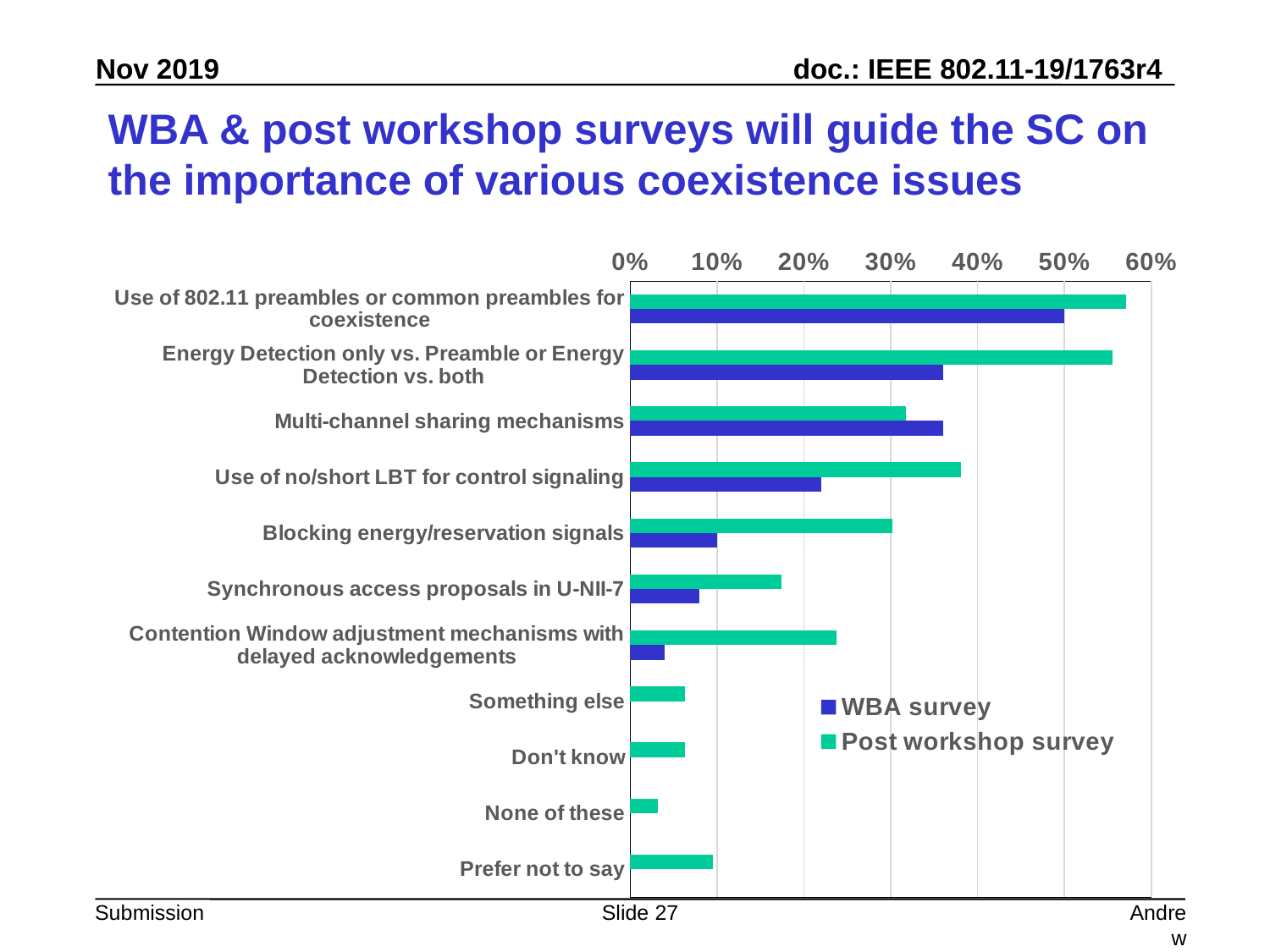
Which series is shown in green in the legend? Post workshop survey For Multi-channel sharing mechanisms, which series has the larger value: WBA survey or Post workshop survey? WBA survey How many series does the legend list? 2 Is the Post workshop survey value for Energy Detection only vs. Preamble or Energy Detection vs. both greater or less than 50%? greater How many categories are shown on the chart? 11 Which category has the highest value for the WBA survey? Use of 802.11 preambles or common preambles for coexistence Is the WBA survey value for Use of no/short LBT for control signaling greater or less than 20%? greater Is the WBA survey value for Synchronous access proposals in U-NII-7 greater or less than 10%? less Which category has the lowest value for the Post workshop survey? None of these What kind of chart is shown on the slide? bar chart For Blocking energy/reservation signals, which series has the larger value: WBA survey or Post workshop survey? Post workshop survey